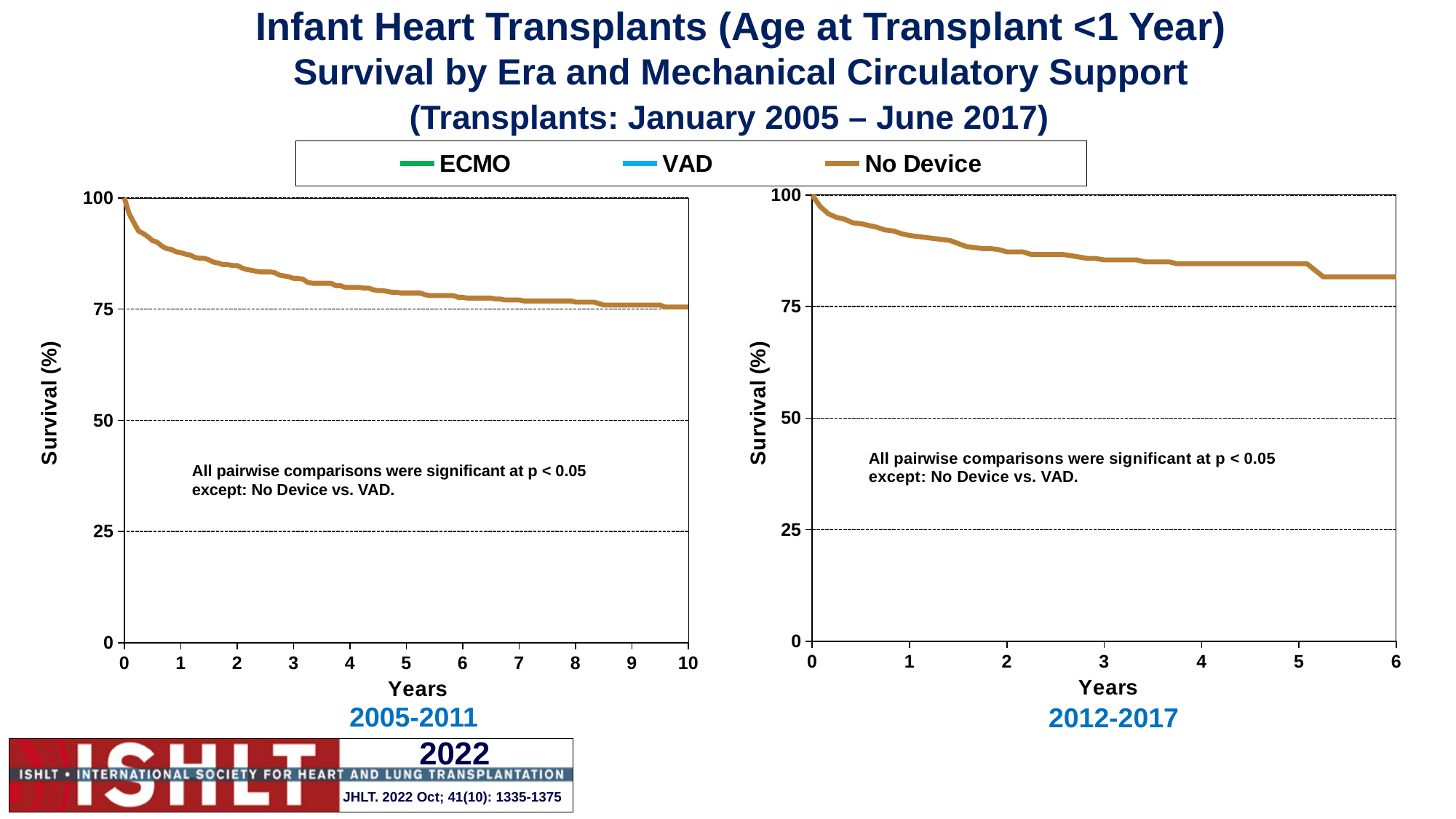
How many series does the legend list? 3 In the 2012-2017 chart, is the No Device survival at 6 years greater or less than 75? greater In the 2012-2017 chart, does the No Device survival curve rise or fall as years increase? fall In the 2012-2017 chart, is the No Device survival at 2 years greater or less than 100? less In the 2005-2011 chart, is the No Device survival at 1 year greater or less than 75? greater What is the maximum value shown on the x axis of the 2005-2011 chart? 10 What is the maximum value shown on the x axis of the 2012-2017 chart? 6 Which series is shown in brown in the legend? No Device In the 2005-2011 chart, does the No Device survival curve rise or fall as years increase? fall What kind of chart is the 2005-2011 chart on the left? line chart